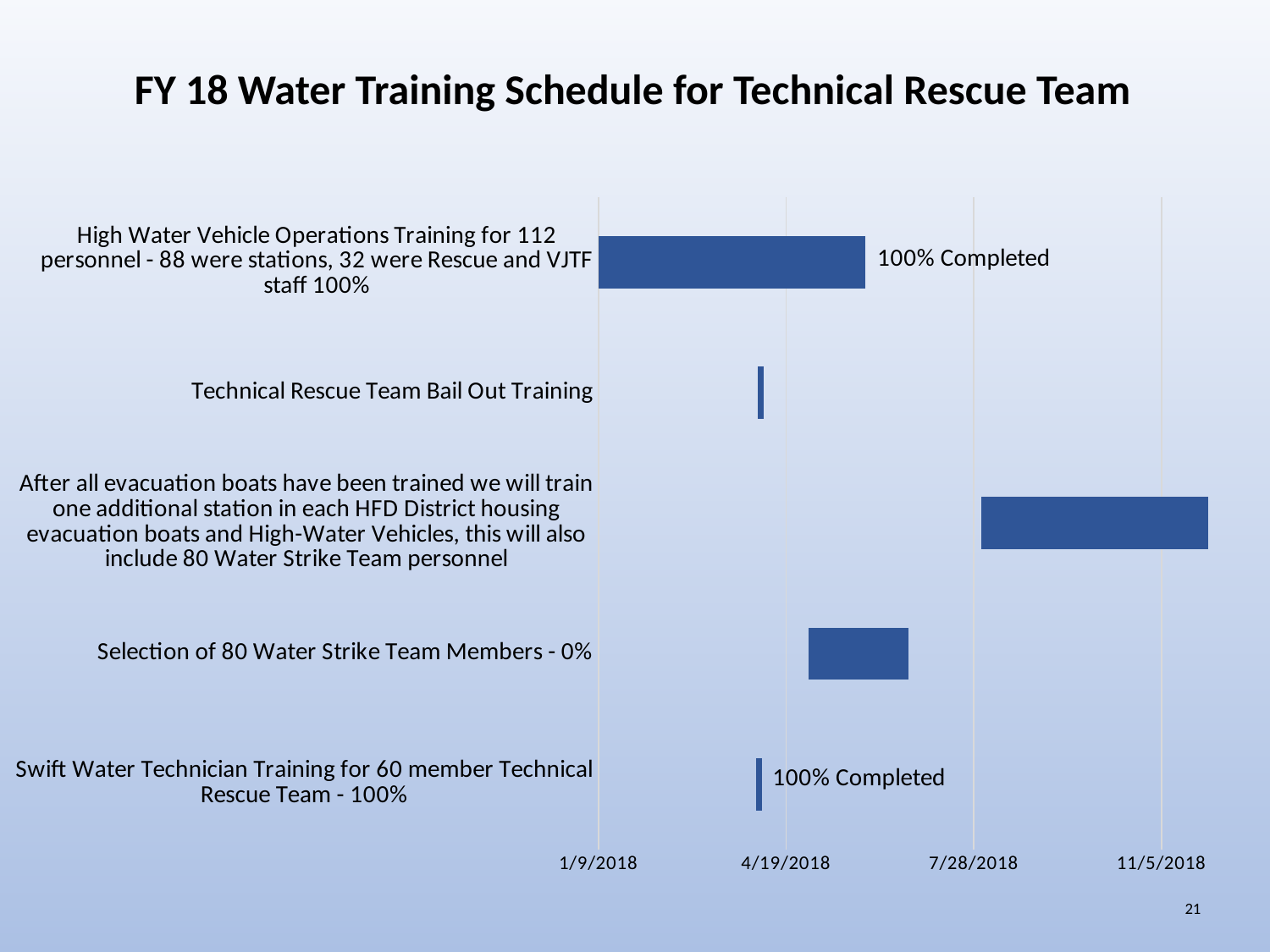
What kind of chart is shown on the slide? Bar chart Which bar is longer: 'Selection of 80 Water Strike Team Members - 0%' or 'Technical Rescue Team Bail Out Training'? Selection of 80 Water Strike Team Members - 0% What is the last date tick shown on the horizontal axis? 11/5/2018 Does the bar for the 'After all evacuation boats have been trained...' task start before or after 7/28/2018? after Does the bar for 'Selection of 80 Water Strike Team Members - 0%' start before or after 4/19/2018? after How many tasks (categories) are plotted on the chart? 5 What is the title of the chart? FY 18 Water Training Schedule for Technical Rescue Team How many bars on the chart carry the data label '100% Completed'? 2 Does the bar for 'Technical Rescue Team Bail Out Training' fall before or after 4/19/2018? before Which task has the bar that starts earliest on the date axis? High Water Vehicle Operations Training for 112 personnel - 88 were stations, 32 were Rescue and VJTF staff 100%